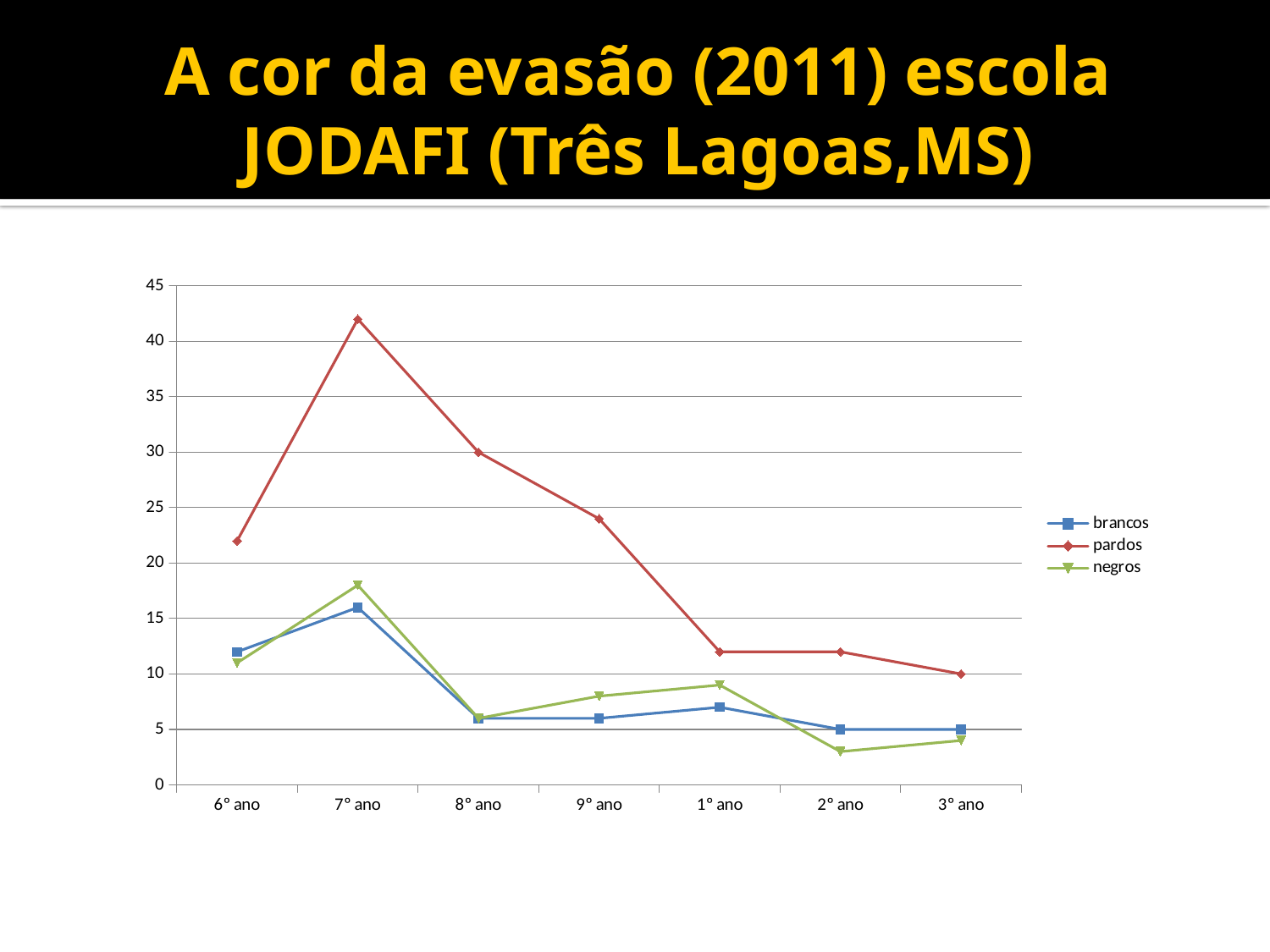
At which school year does the pardos series reach its highest value? 7° ano Does the pardos series rise or fall from 7° ano to 3° ano? fall How many series does the legend list? 3 Which series has the highest value at 6° ano? pardos Is the value for negros at 2° ano greater or less than 5? less What is the value for brancos at 3° ano? 5 What is the value for pardos at 8° ano? 30 What is the value for pardos at 3° ano? 10 Is the value for pardos at 7° ano greater or less than 40? greater How many school-year categories are shown on the x axis? 7 What kind of chart is shown on the slide? line chart Is the value for negros at 7° ano greater or less than 15? greater